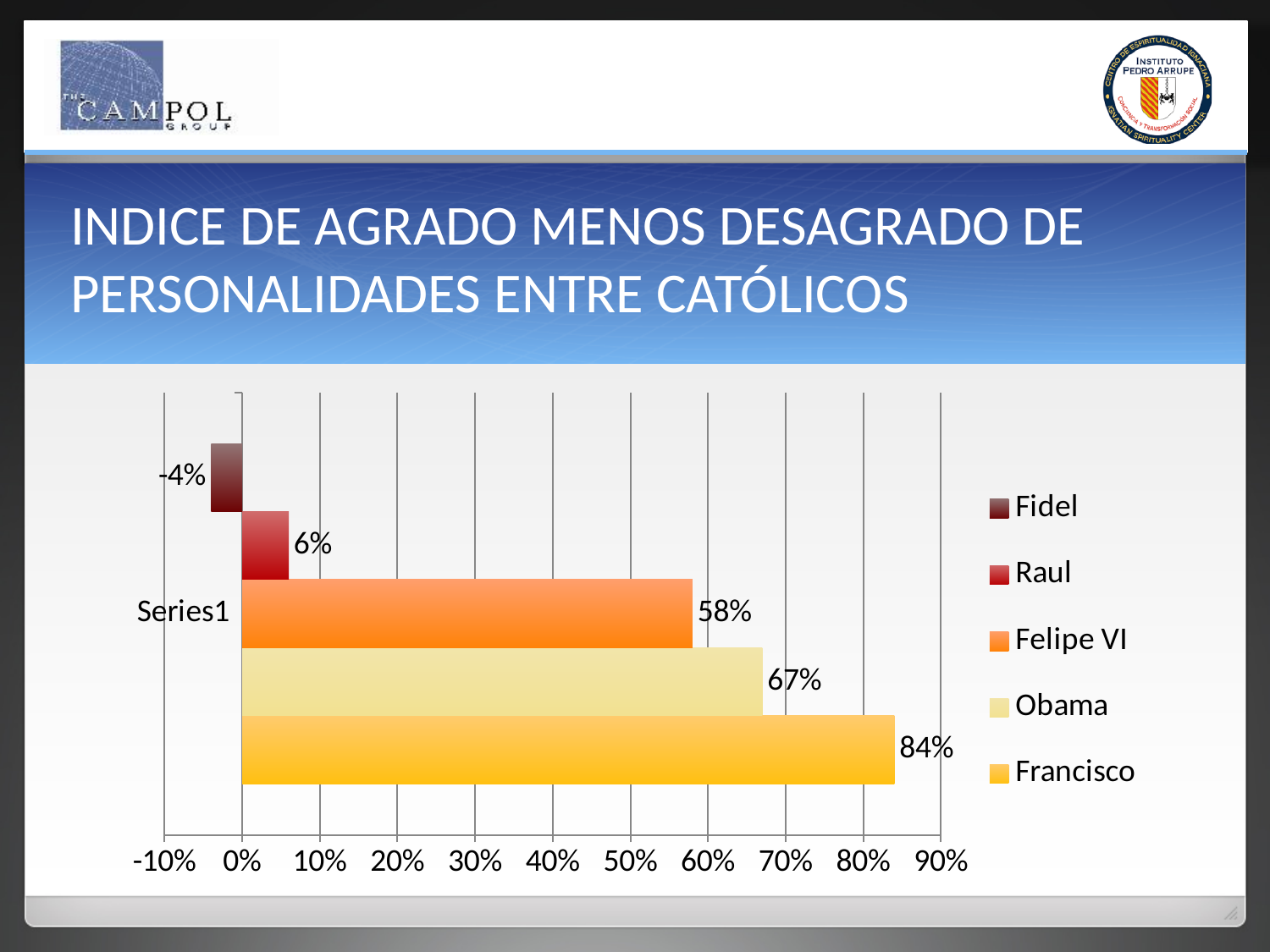
Which personality has the highest value? Francisco How many series does the legend list? 5 What is the value for Francisco? 84% Which is larger, the value for Felipe VI or the value for Obama? Obama What is the value for Felipe VI? 58% What colour is the bar for Felipe VI? Orange What is the difference between the values for Francisco and Obama? 17% What is the value for Obama? 67% What kind of chart is shown on the slide? Bar chart What is the difference between the values for Raul and Fidel? 10% Which personality has the lowest value? Fidel What is the value for Fidel? -4%